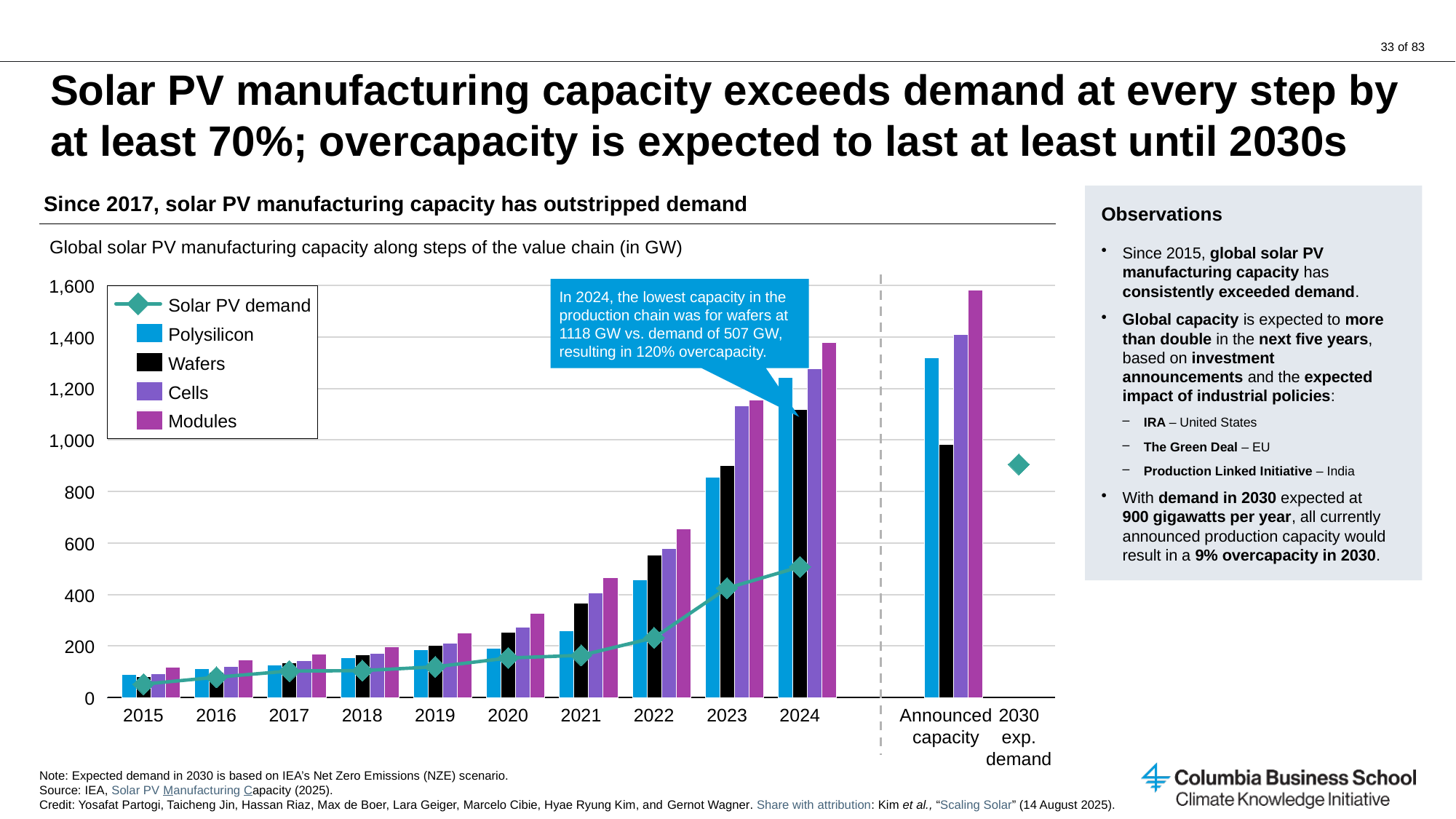
According to the callout, what was the wafer manufacturing capacity in 2024? 1118 GW What is the difference between wafer capacity and solar PV demand in 2024, using the values in the callout? 611 GW How many entries does the chart legend list? 5 What kind of chart is shown on the slide? combination bar and line chart Which year has the lowest Modules capacity? 2015 Is the Modules capacity in 2024 greater or less than 1,200 GW? greater According to the callout, what was solar PV demand in 2024? 507 GW Does solar PV demand rise or fall from 2015 to 2024? rise Is the Polysilicon capacity in 2015 greater or less than 200 GW? less How many years from 2015 onward are shown on the x axis before the dashed divider? 10 Which value chain step has the highest capacity in 2024? Modules Is the Modules value for Announced capacity greater or less than 1,400 GW? greater